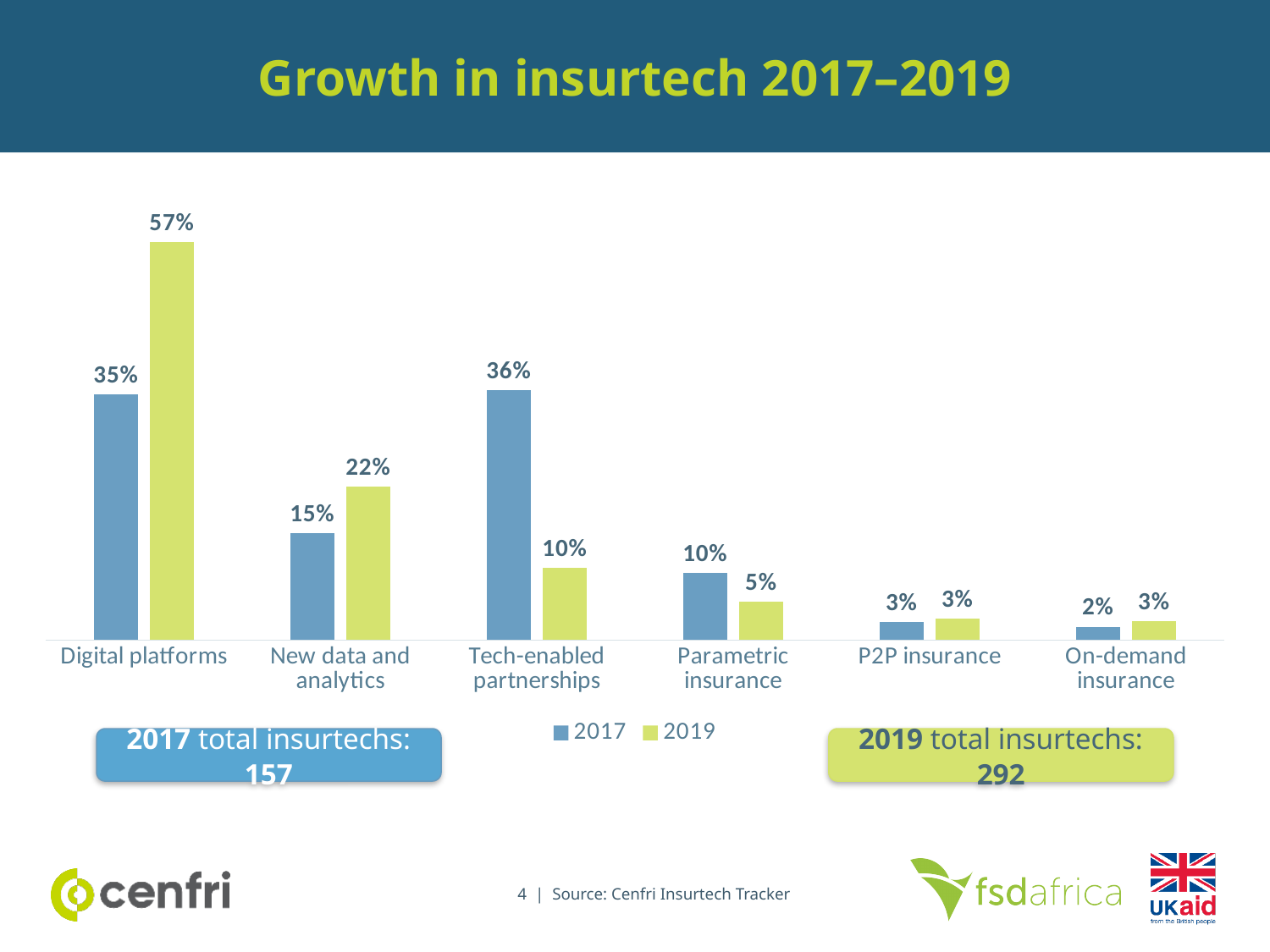
What is the 2019 value for Digital platforms? 57% What is the difference between the 2019 and 2017 values for Digital platforms? 22% How many categories are shown on the x axis? 6 What is the difference between the 2017 and 2019 values for Tech-enabled partnerships? 26% What is the 2017 value for On-demand insurance? 2% What kind of chart is shown on the slide? Bar chart How many series does the legend list? 2 Which category has the highest 2019 value? Digital platforms Which is larger for New data and analytics, the 2017 value or the 2019 value? 2019 Which category has the lowest 2017 value? On-demand insurance What is the 2019 value for Parametric insurance? 5% What is the 2017 value for Tech-enabled partnerships? 36%